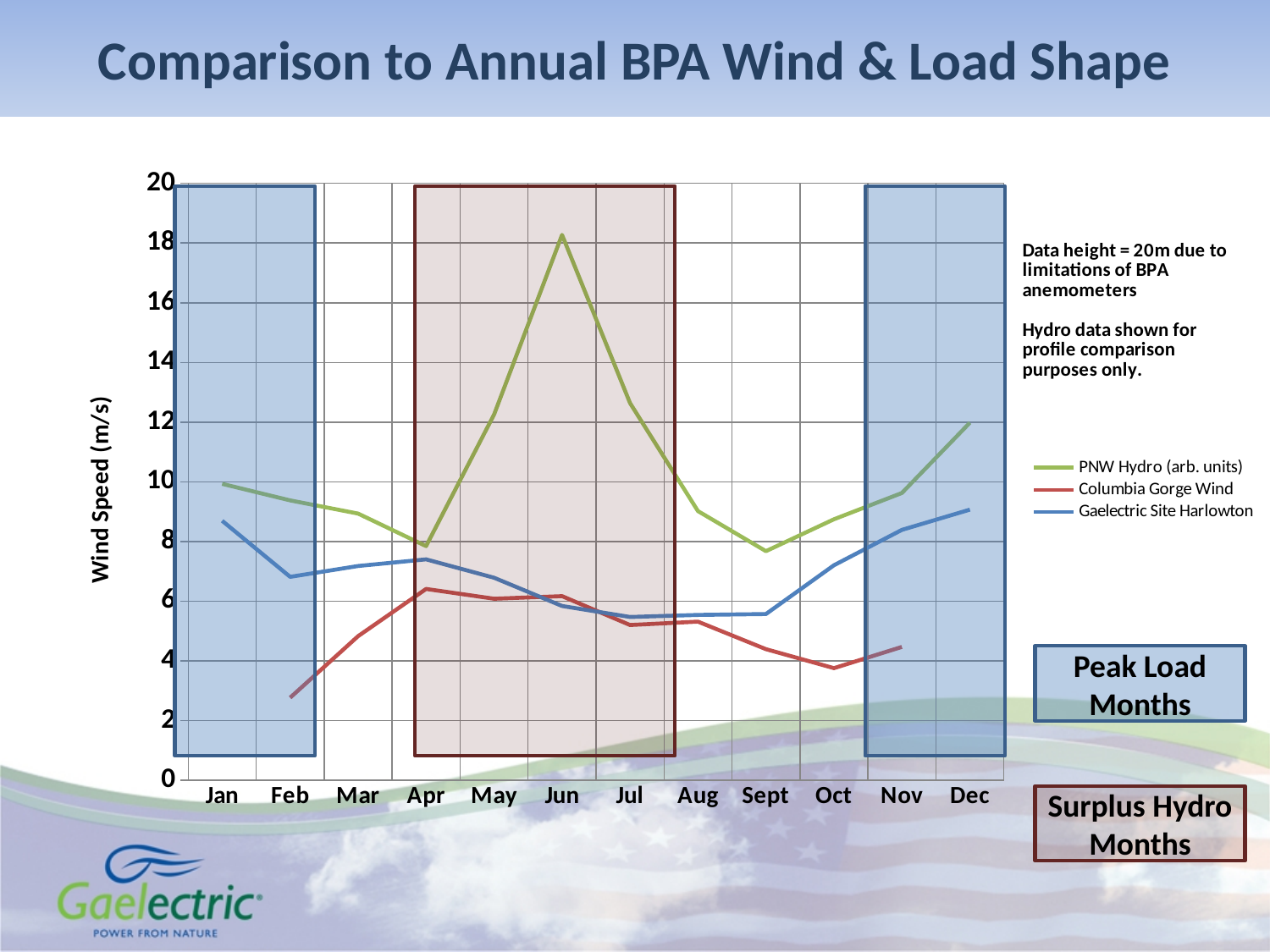
How many months are shown along the x axis? 12 Is the PNW Hydro (arb. units) value in Jun greater or less than 16? greater Is the Columbia Gorge Wind value in Feb greater or less than 4? less What is the title of the y axis? Wind Speed (m/s) What type of chart is shown on the slide? Line chart Does the Gaelectric Site Harlowton series rise or fall from Sept to Dec? Rise In which month is the Columbia Gorge Wind series at its lowest value? Feb In Jan, which series has the higher value: PNW Hydro (arb. units) or Gaelectric Site Harlowton? PNW Hydro (arb. units) In which month does the PNW Hydro (arb. units) series reach its highest value? Jun How many series does the legend list? 3 Is the Gaelectric Site Harlowton value in Dec greater or less than 8? greater Does the PNW Hydro (arb. units) series rise or fall from Jan to Apr? Fall